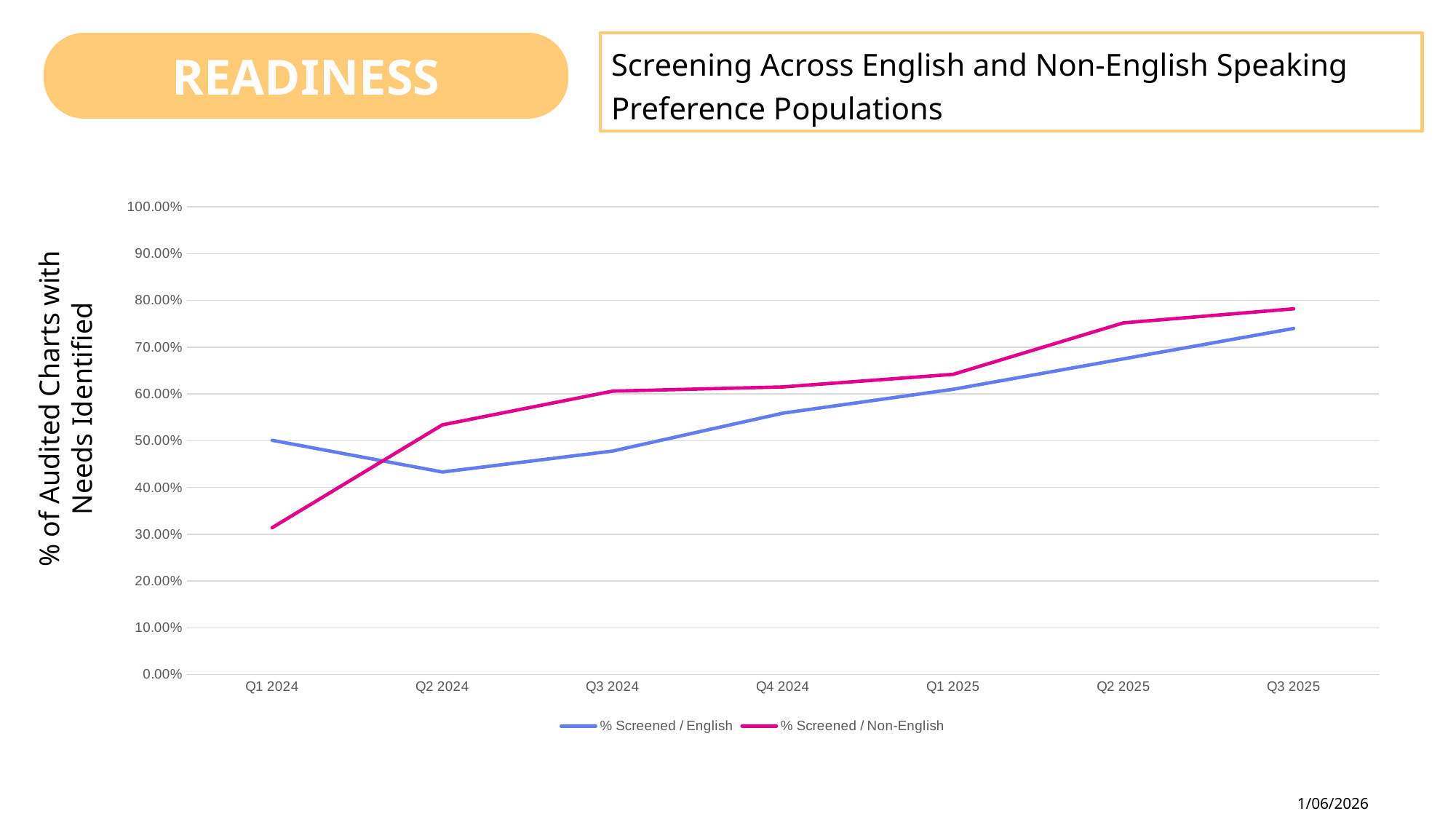
In which quarter is the % Screened / English value lowest? Q2 2024 Is the % Screened / Non-English value for Q1 2024 greater or less than 40.00%? less Is the % Screened / English value for Q3 2025 greater or less than 70.00%? greater How many quarters are plotted along the x axis? 7 In which quarter is the % Screened / Non-English value highest? Q3 2025 How many series does the legend list? 2 In Q3 2025, which series has the larger value, % Screened / English or % Screened / Non-English? % Screened / Non-English In Q1 2024, which series has the larger value, % Screened / English or % Screened / Non-English? % Screened / English Does the % Screened / Non-English line rise or fall from Q1 2024 to Q3 2025? Rises In which quarter is the % Screened / Non-English value lowest? Q1 2024 What is the title of the vertical axis? % of Audited Charts with Needs Identified What kind of chart is shown on the slide? Line chart